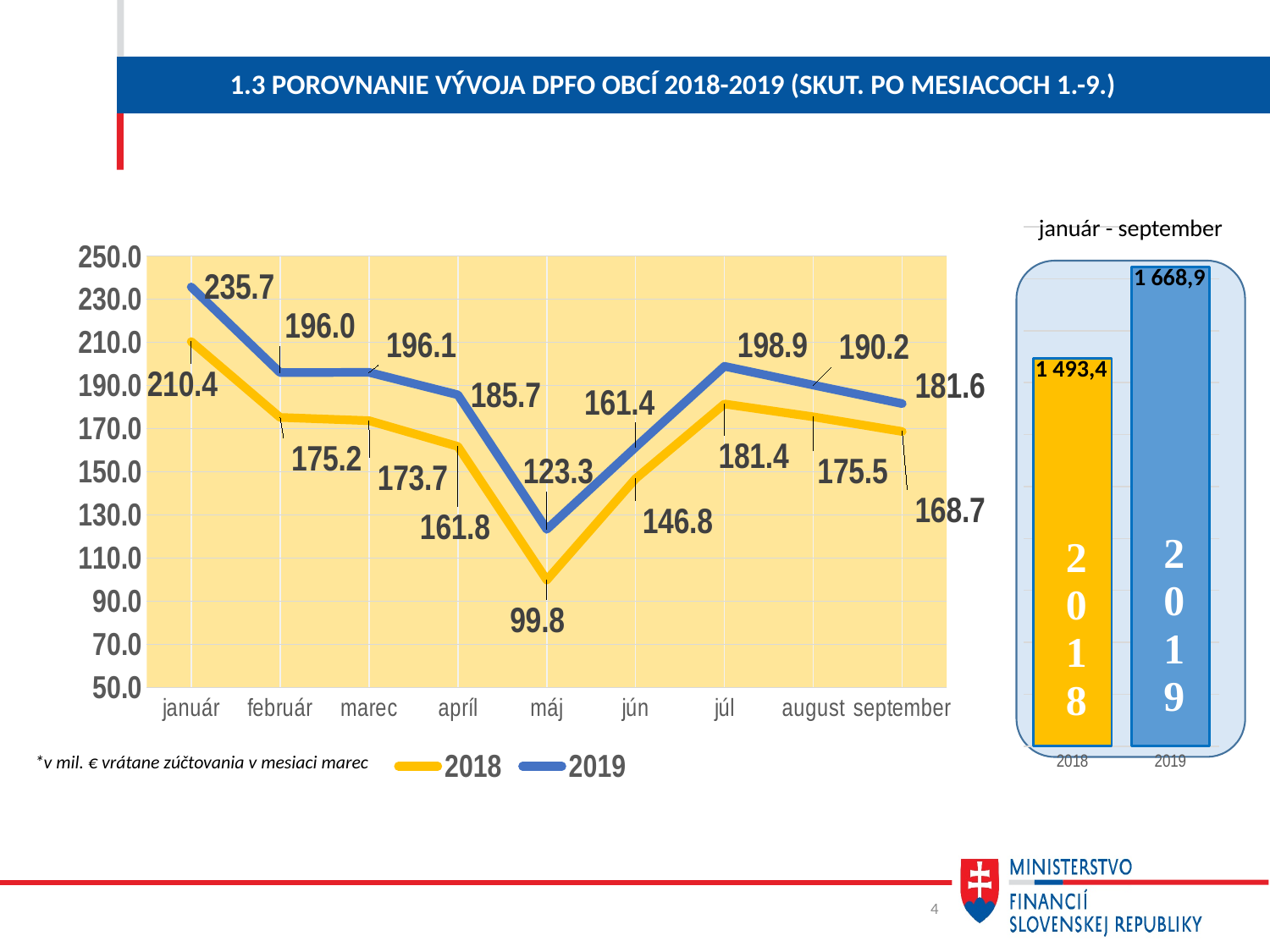
In the line chart on the left, what is the difference between the 2019 and 2018 values for júl? 17.5 In the line chart on the left, which month has the highest 2018 value? január In the line chart on the left, what is the 2018 value for máj? 99.8 In the line chart on the left, which is larger: the 2019 value for apríl or the 2019 value for jún? apríl In the bar chart on the right titled 'január - september', what is the difference between the 2019 and 2018 values? 175,5 In the line chart on the left, which month has the lowest 2019 value? máj In the line chart on the left, what is the 2019 value for január? 235.7 In the line chart on the left, how many months are shown on the x axis? 9 In the line chart on the left, how many series does the legend list? 2 In the bar chart on the right titled 'január - september', what is the value for 2019? 1 668,9 What kind of chart is the chart on the right titled 'január - september'? bar chart In the line chart on the left, what is the 2018 value for september? 168.7